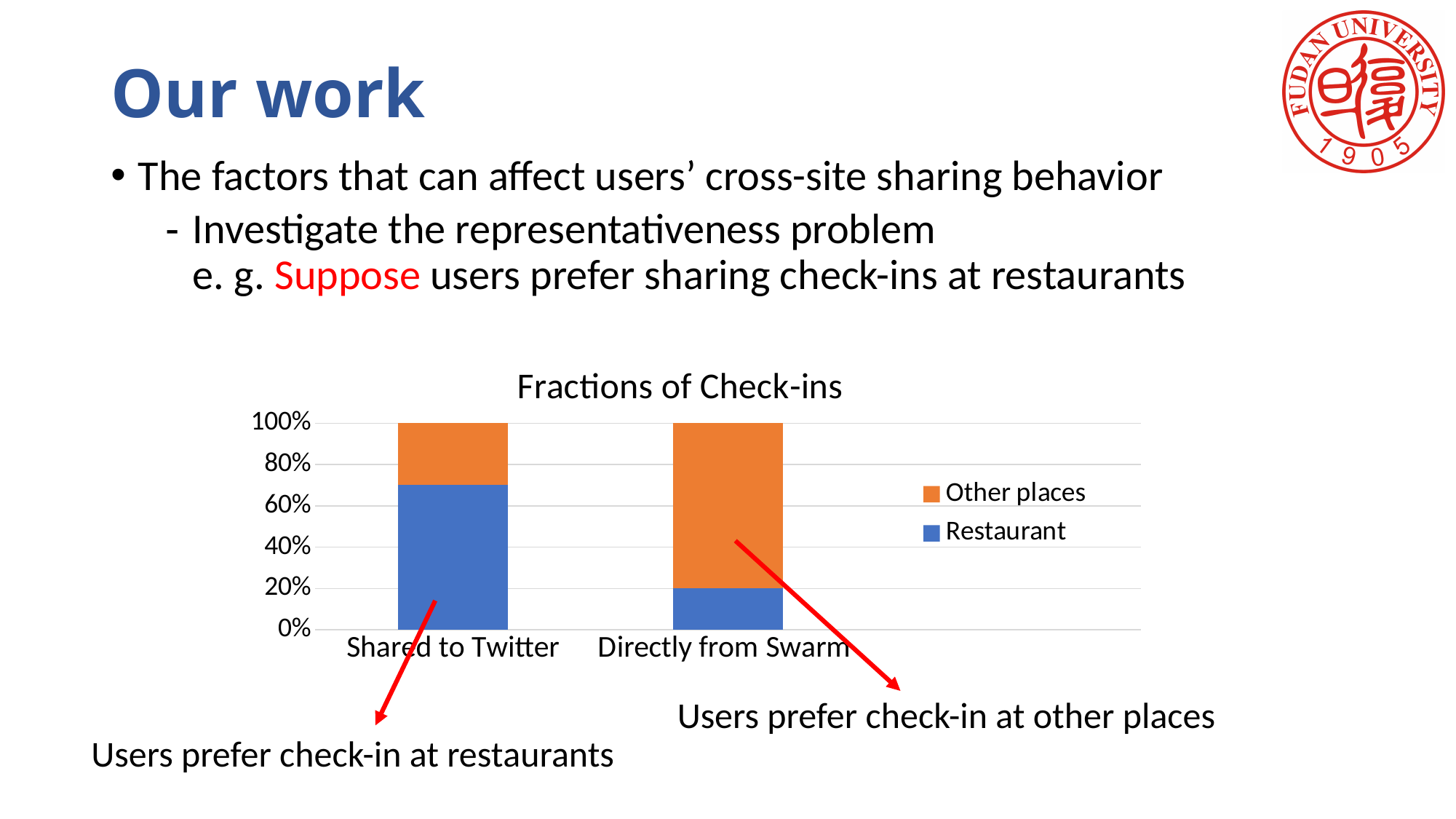
Is the Restaurant value for Shared to Twitter greater or less than 60%? greater What is the title of the chart? Fractions of Check-ins Which category has the highest Other places share? Directly from Swarm What kind of chart is shown on the slide? stacked bar chart How many categories are shown on the x axis of the chart? 2 Which category has the larger Restaurant share, Shared to Twitter or Directly from Swarm? Shared to Twitter Is the Other places value for Shared to Twitter greater or less than 40%? less What is the total height of the stacked bar for Shared to Twitter? 100% How many series does the chart's legend list? 2 Is the Other places value for Directly from Swarm greater or less than 60%? greater Which series is shown in orange in the chart? Other places